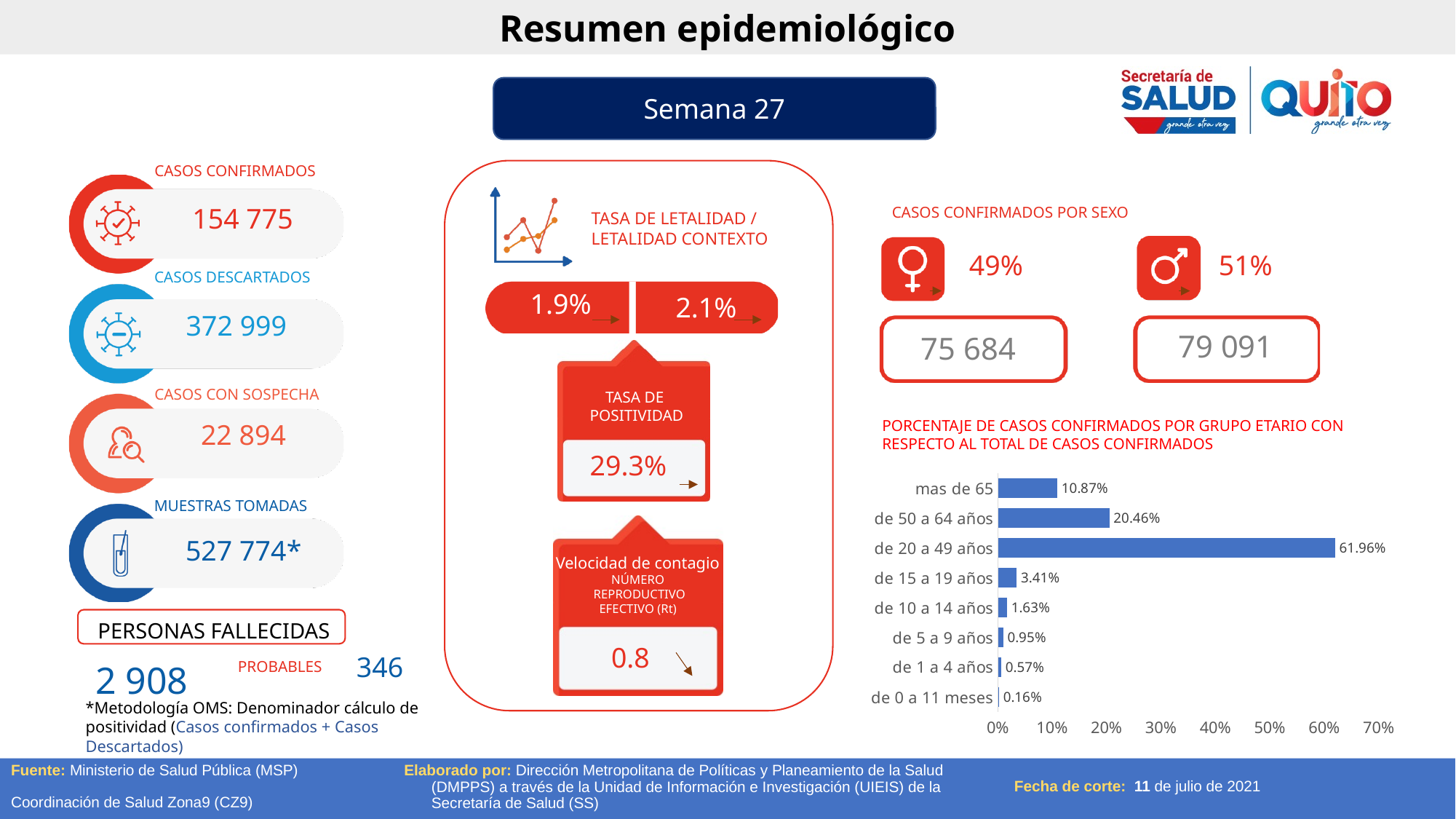
What is the difference between the percentages for 'de 50 a 64 años' and 'mas de 65' in the bar chart? 9.59% Which age group has the highest percentage of confirmed cases in the bar chart? de 20 a 49 años What percentage of confirmed cases does the bar chart show for the 'de 20 a 49 años' age group? 61.96% What value does the bar chart show for 'de 15 a 19 años'? 3.41% What type of chart is used to show the percentage of confirmed cases by age group? Bar chart What value is shown for 'mas de 65' in the bar chart? 10.87% What percentage is shown for the 'de 0 a 11 meses' group in the bar chart? 0.16% Is the value for 'de 50 a 64 años' in the bar chart greater or less than 30%? less Which age group has the lowest percentage of confirmed cases in the bar chart? de 0 a 11 meses In the bar chart, which is larger: the value for 'de 10 a 14 años' or 'de 5 a 9 años'? de 10 a 14 años What is the highest value shown on the horizontal axis of the bar chart? 70% How many age groups are shown in the bar chart? 8